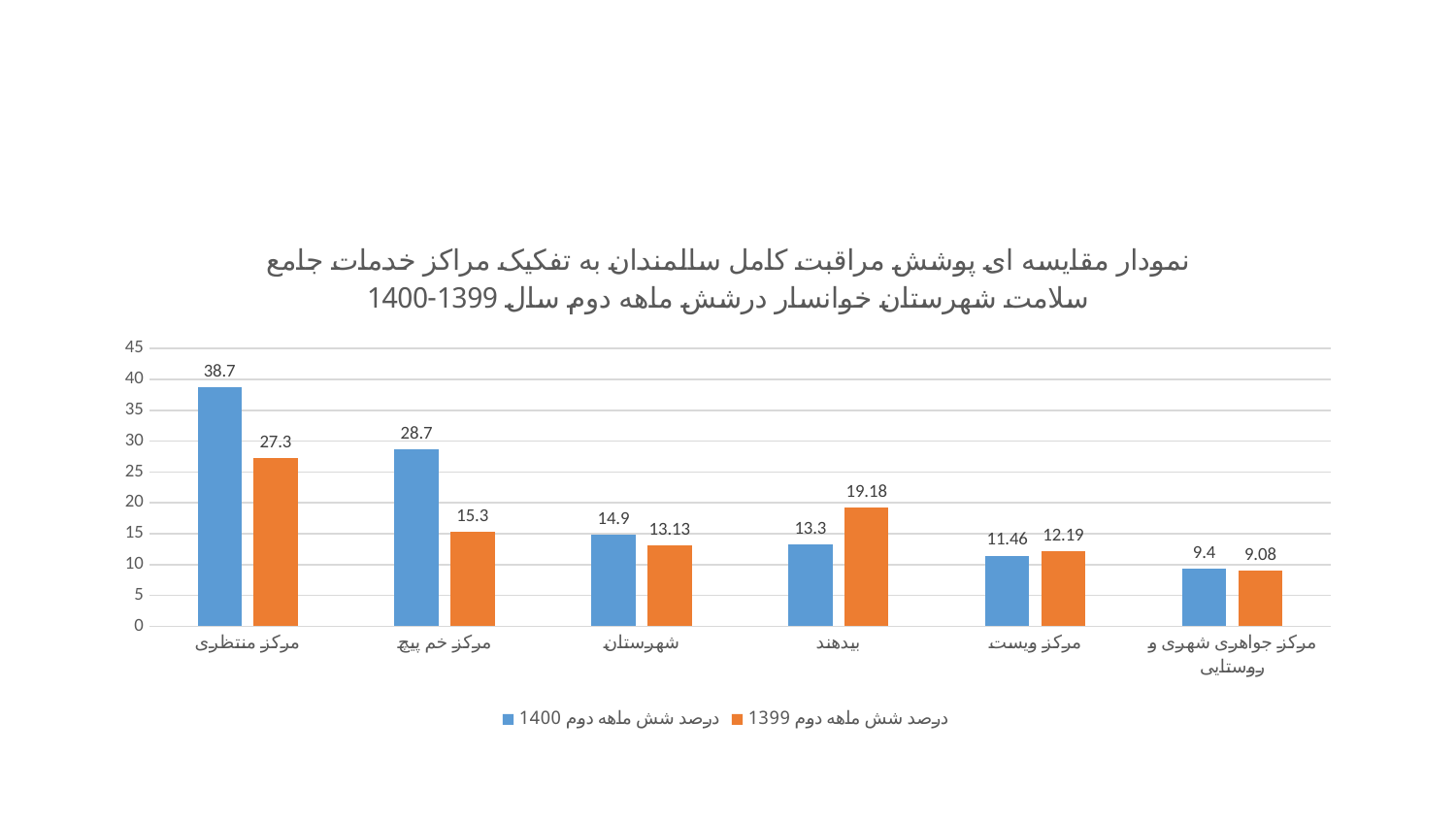
Do the values in the 1400 series rise or fall from left to right along the x axis? Fall What is the value for مرکز منتظری in the 1400 series (درصد شش ماهه دوم 1400)? 38.7 What kind of chart is shown on the slide? Bar chart Which category has the highest value in the 1400 series? مرکز منتظری Which category has the lowest value in the 1399 series? مرکز جواهری شهری و روستایی How many series does the legend list? 2 What is the value for بیدهند in the 1399 series (درصد شش ماهه دوم 1399)? 19.18 Which colour represents the 1399 series (درصد شش ماهه دوم 1399)? Orange What is the difference between the 1400 and 1399 values for مرکز خم پیچ? 13.4 How many categories are shown on the x axis? 6 For بیدهند, which series has the larger value, 1400 or 1399? 1399 What is the value for مرکز ویست in the 1400 series? 11.46